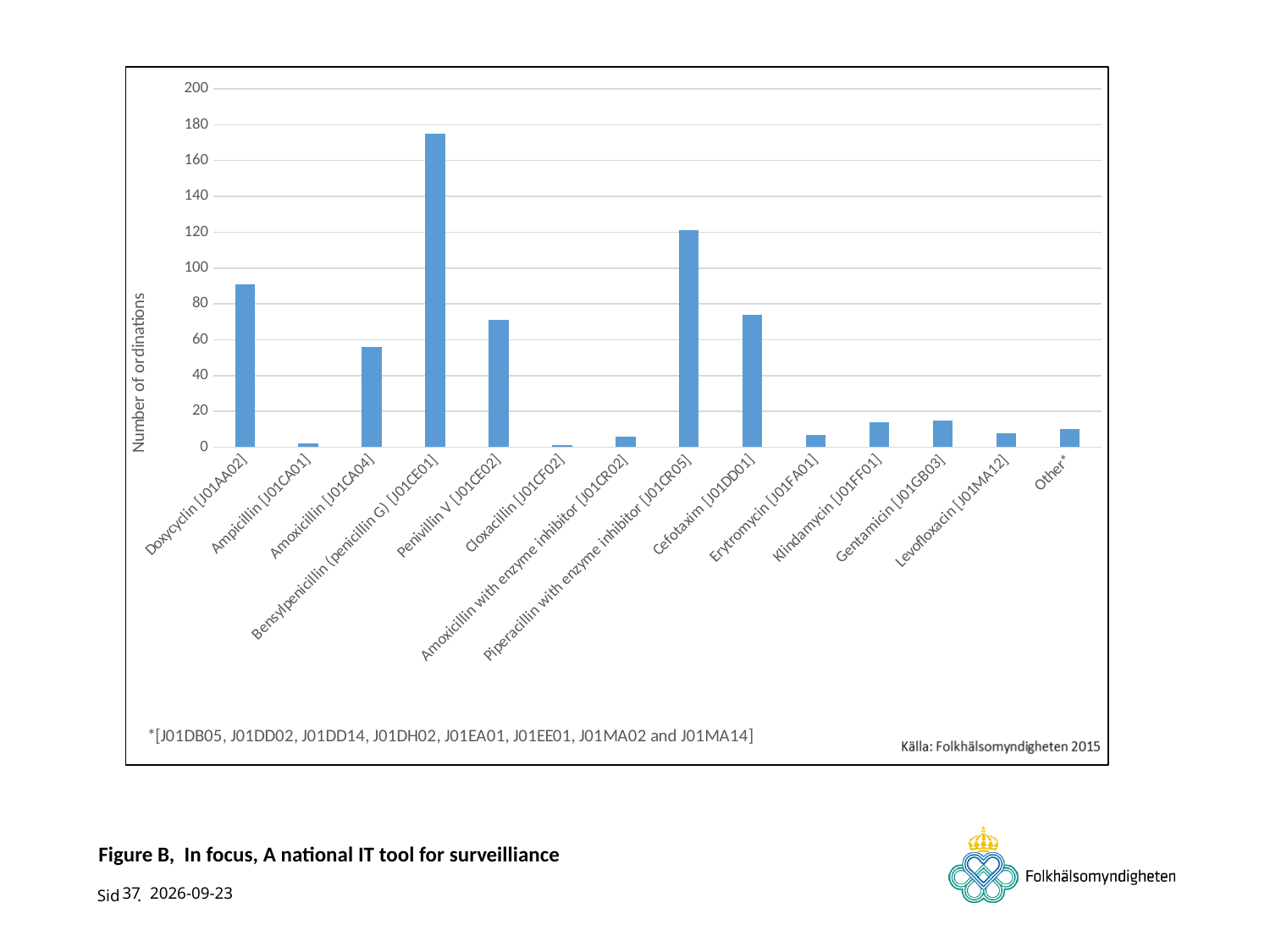
Which category has the highest number of ordinations? Bensylpenicillin (penicillin G) [J01CE01] Is the value for Amoxicillin [J01CA04] greater or less than 40? greater Is the value for Bensylpenicillin (penicillin G) [J01CE01] greater or less than 160? greater Is the value for Piperacillin with enzyme inhibitor [J01CR05] greater or less than 100? greater What is the label of the y axis? Number of ordinations What kind of chart is shown on the slide? bar chart How many categories are shown on the x axis? 14 Which has more ordinations, Amoxicillin [J01CA04] or Penivillin V [J01CE02]? Penivillin V [J01CE02] Which has more ordinations, Doxycyclin [J01AA02] or Cefotaxim [J01DD01]? Doxycyclin [J01AA02]